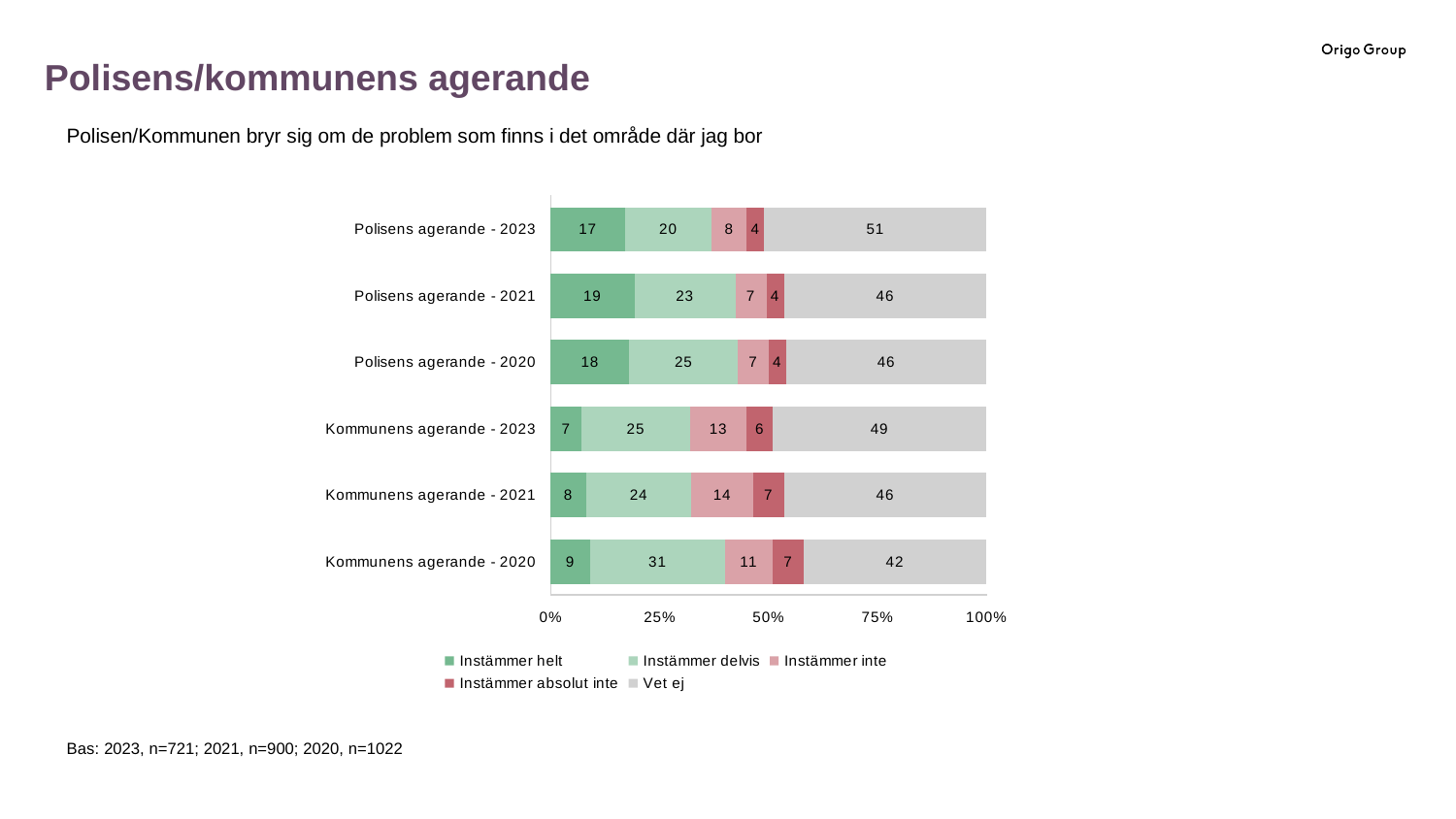
How many categories (bars) does the chart show? 6 What is the value of "Vet ej" for "Polisens agerande - 2023"? 51 Which category has the lowest value for "Vet ej"? Kommunens agerande - 2020 What is the value of "Instämmer helt" for "Polisens agerande - 2021"? 19 What is the difference between the "Instämmer helt" values for "Polisens agerande - 2023" and "Kommunens agerande - 2023"? 10 What kind of chart is shown on the slide? Stacked bar chart What is the total of the stacked bar for "Kommunens agerande - 2020"? 100 Which category has the highest value for "Instämmer helt"? Polisens agerande - 2021 Which is larger: the "Instämmer absolut inte" value for "Kommunens agerande - 2023" or for "Polisens agerande - 2023"? Kommunens agerande - 2023 How many series does the legend list? 5 What is the value of "Instämmer delvis" for "Kommunens agerande - 2020"? 31 What is the value of "Instämmer inte" for "Kommunens agerande - 2021"? 14